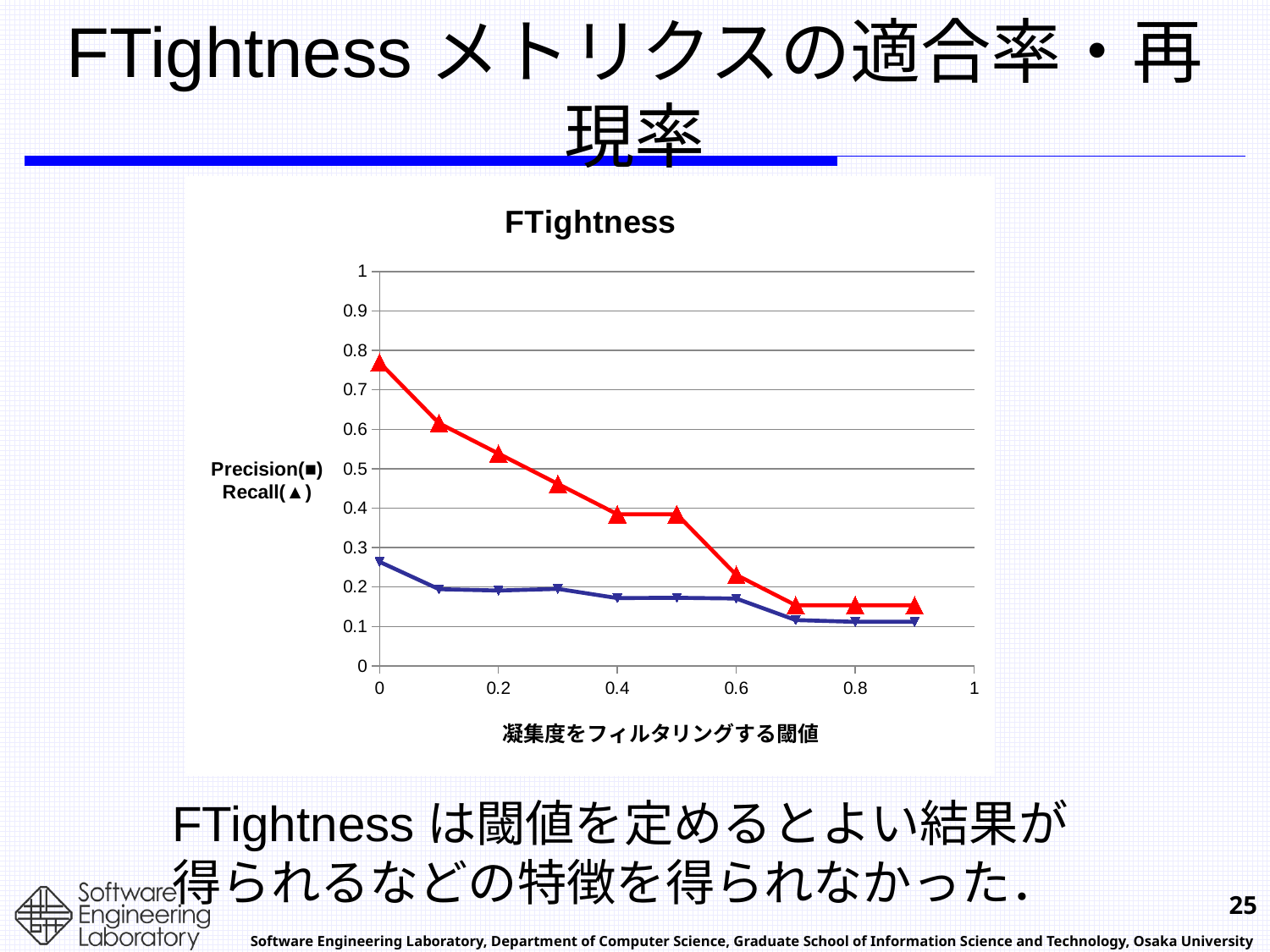
Which two series are plotted in the chart? Precision and Recall Is the Precision value at threshold 0 greater or less than 0.3? less What kind of chart is shown on the slide? line chart Is the Recall value at threshold 0 greater or less than 0.7? greater How many data points does the Recall series have? 10 How many series does the chart plot? 2 At threshold 0, which is larger, Precision or Recall? Recall At which threshold value is Recall highest? 0 At which threshold value is Precision highest? 0 Is the Recall value at threshold 0.9 greater or less than 0.2? less What is the title of the chart? FTightness Do the Recall values rise or fall as the threshold on the x axis increases? fall